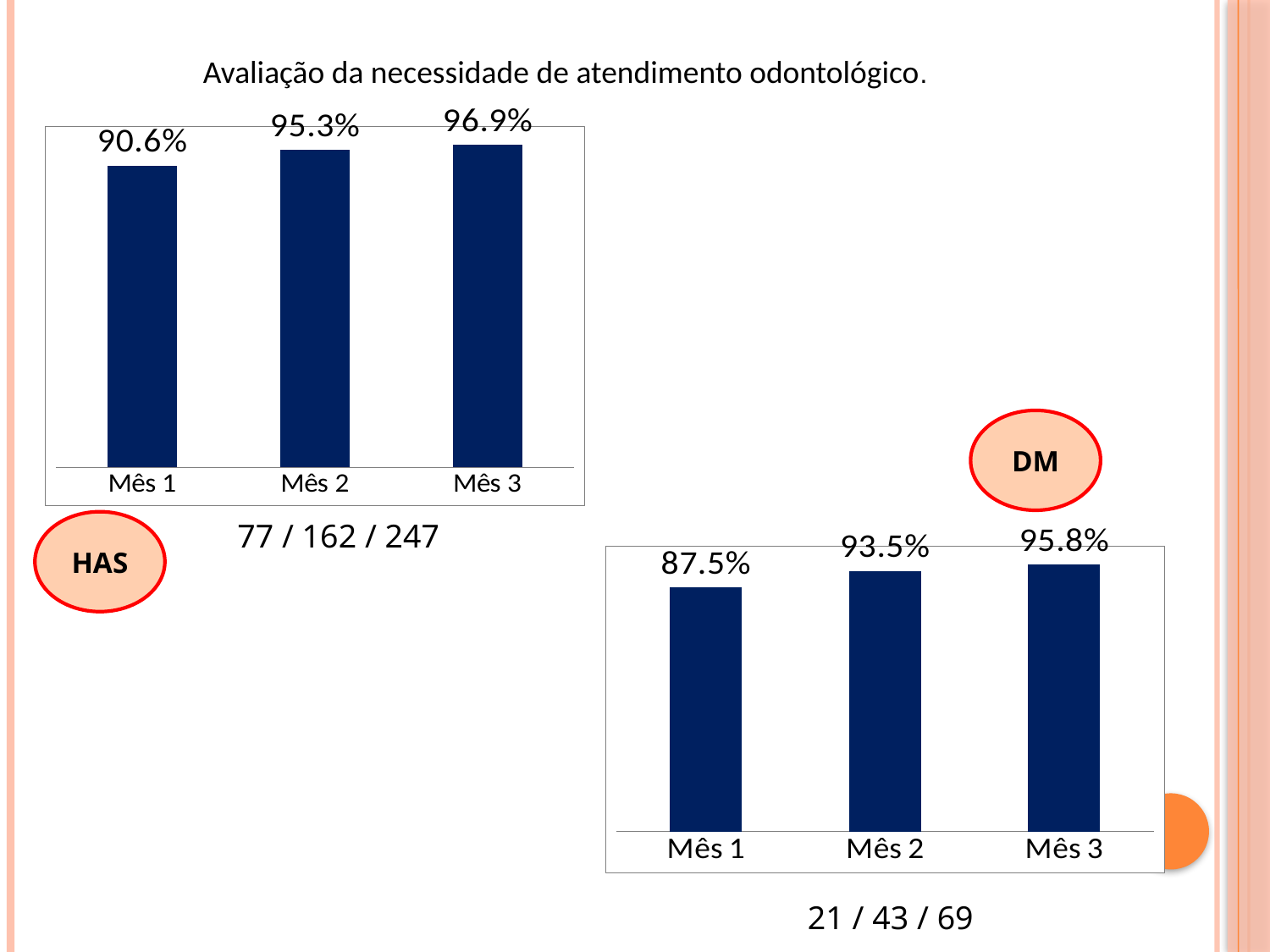
In the HAS chart (top left), which month has the highest value? Mês 3 In the HAS chart (top left), what is the value for Mês 3? 96.9% How many bars are shown in the DM chart (bottom right)? 3 In the DM chart (bottom right), what is the value for Mês 1? 87.5% In the DM chart (bottom right), what is the difference between the values for Mês 3 and Mês 1? 8.3 percentage points In the HAS chart (top left), what is the value for Mês 1? 90.6% In the DM chart (bottom right), which month has the lowest value? Mês 1 In the DM chart (bottom right), what is the value for Mês 2? 93.5% What type of chart is the HAS chart (top left)? Bar chart In the DM chart (bottom right), do the values rise or fall from Mês 1 to Mês 3? Rise In the HAS chart (top left), what is the difference between the values for Mês 3 and Mês 1? 6.3 percentage points Which is larger: the Mês 2 value in the HAS chart or the Mês 2 value in the DM chart? HAS chart (95.3%)